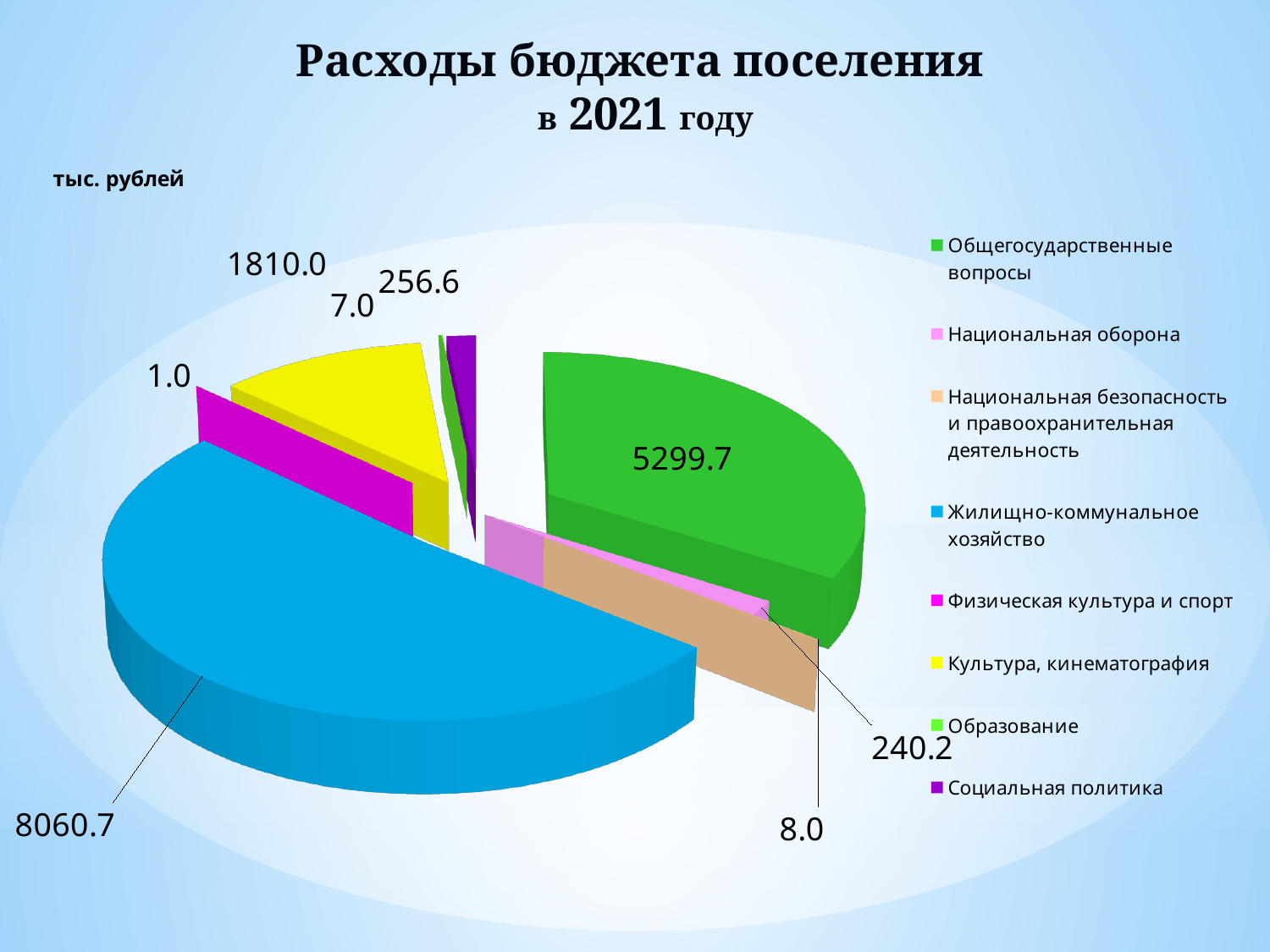
What type of chart is shown on the slide? pie chart Which category has the largest value? Жилищно-коммунальное хозяйство What is the value for Национальная безопасность и правоохранительная деятельность? 8.0 Which is larger, the value for Образование or the value for Национальная оборона? Национальная оборона What is the value for Культура, кинематография? 1810.0 What is the value for Социальная политика? 256.6 What is the value for Общегосударственные вопросы? 5299.7 Which category has the smallest value? Физическая культура и спорт How many categories does the legend list? 8 What is the difference between the values for Жилищно-коммунальное хозяйство and Общегосударственные вопросы? 2761.0 What is the value for Жилищно-коммунальное хозяйство? 8060.7 What unit is stated for the values on the chart? тыс. рублей